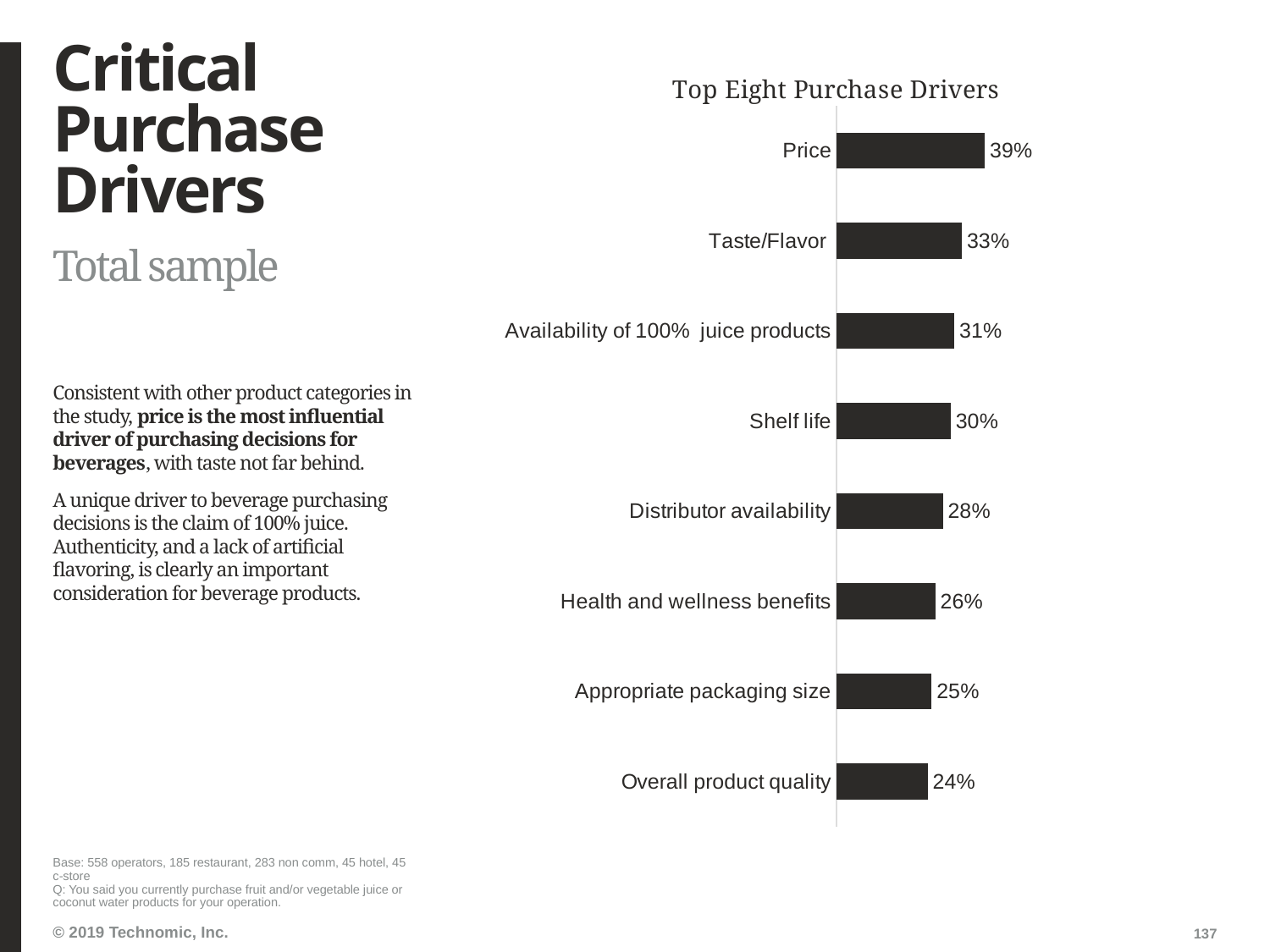
What is the value for Health and wellness benefits? 26% Which purchase driver has the highest value? Price What is the difference between the values for Price and Taste/Flavor? 6% What is the title of the chart? Top Eight Purchase Drivers What is the value for Price? 39% Do the values rise or fall going from the top bar to the bottom bar? Fall What is the difference between the values for Availability of 100% juice products and Overall product quality? 7% What is the value for Shelf life? 30% What kind of chart is shown on the slide? Bar chart How many purchase drivers are shown in the chart? 8 Which purchase driver has the lowest value? Overall product quality Which is larger, the value for Distributor availability or the value for Appropriate packaging size? Distributor availability